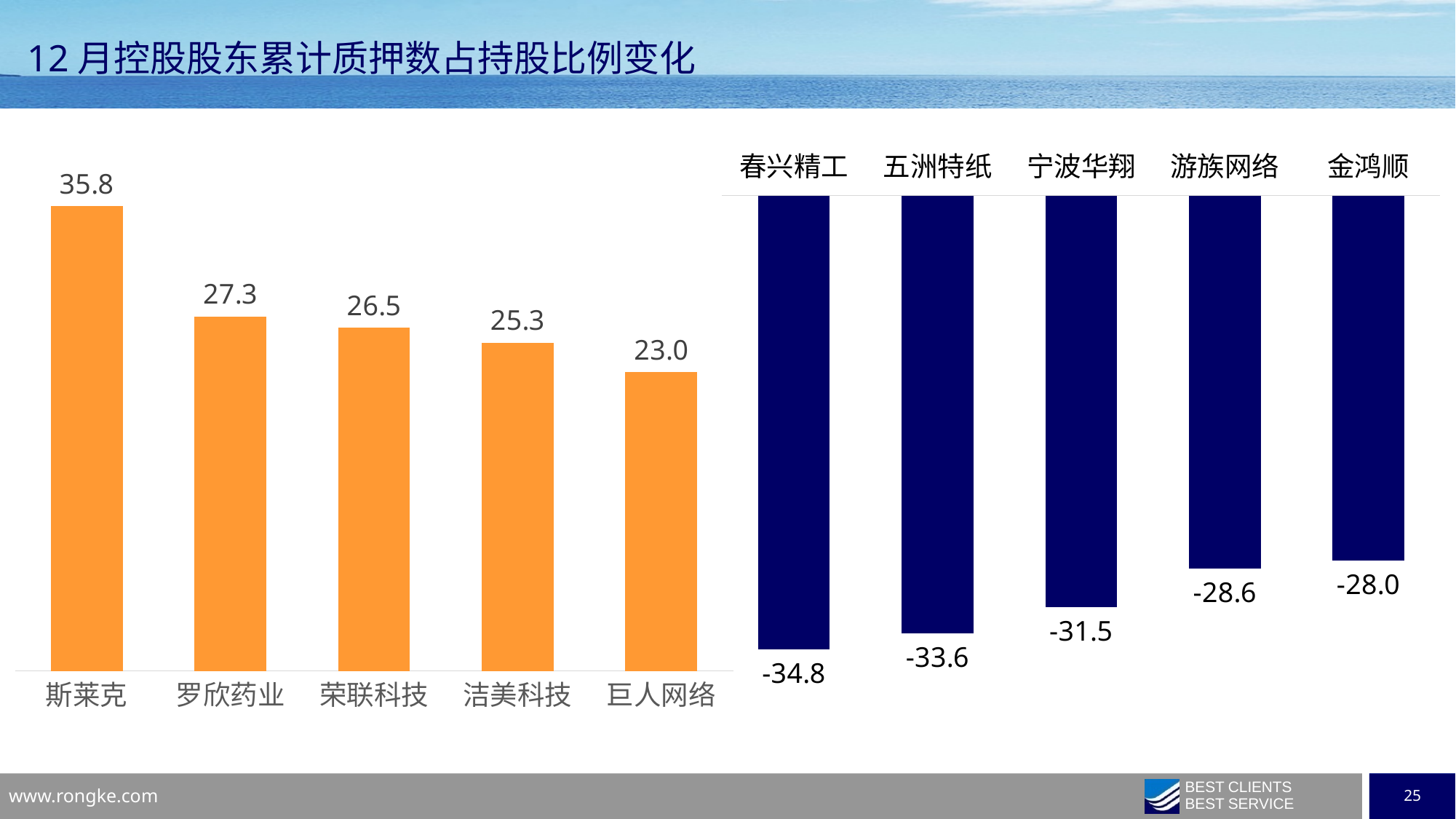
In the left chart (orange bars), what is the value for 巨人网络? 23.0 In the left chart (orange bars), do the values rise or fall from left to right? Fall In the left chart (orange bars), what is the value for 斯莱克? 35.8 In the right chart (dark blue bars), what is the value for 宁波华翔? -31.5 In the right chart (dark blue bars), which category has the lowest value? 春兴精工 In the left chart (orange bars), what is the difference between the values for 斯莱克 and 罗欣药业? 8.5 How many categories are shown in the right chart (dark blue bars)? 5 In the left chart (orange bars), which is larger, the value for 荣联科技 or 洁美科技? 荣联科技 In the left chart (orange bars), which category has the highest value? 斯莱克 In the right chart (dark blue bars), what is the difference between the values for 游族网络 and 春兴精工? 6.2 What kind of chart is the left chart (orange bars)? Bar chart In the right chart (dark blue bars), what is the value for 金鸿顺? -28.0